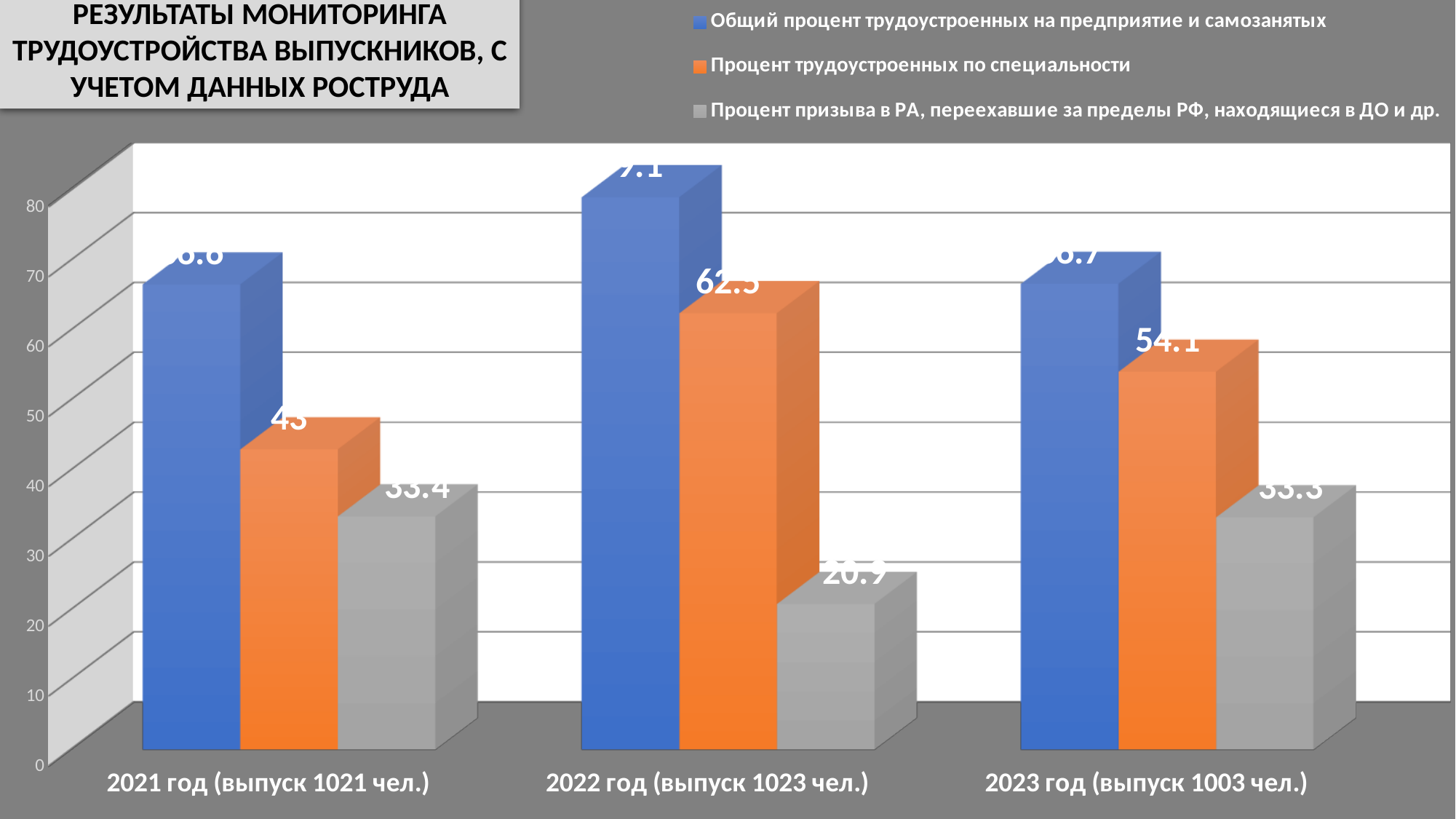
What type of chart is shown on the slide? bar chart How many year categories are shown on the x axis? 3 Is the value of 'Общий процент трудоустроенных на предприятие и самозанятых' for 2022 год (выпуск 1023 чел.) greater or less than 70? greater What is the value of 'Процент призыва в РА, переехавшие за пределы РФ, находящиеся в ДО и др.' for 2022 год (выпуск 1023 чел.)? 20.9 In which year is 'Процент трудоустроенных по специальности' highest? 2022 год (выпуск 1023 чел.) Which series is shown in orange in the legend? Процент трудоустроенных по специальности In which year is 'Процент призыва в РА, переехавшие за пределы РФ, находящиеся в ДО и др.' lowest? 2022 год (выпуск 1023 чел.) What is the value of 'Процент трудоустроенных по специальности' for 2023 год (выпуск 1003 чел.)? 54.1 What is the value of 'Процент трудоустроенных по специальности' for 2021 год (выпуск 1021 чел.)? 43 How many series does the legend list? 3 What is the value of 'Процент трудоустроенных по специальности' for 2022 год (выпуск 1023 чел.)? 62.5 What is the difference between 'Процент трудоустроенных по специальности' in 2022 and in 2021? 19.5